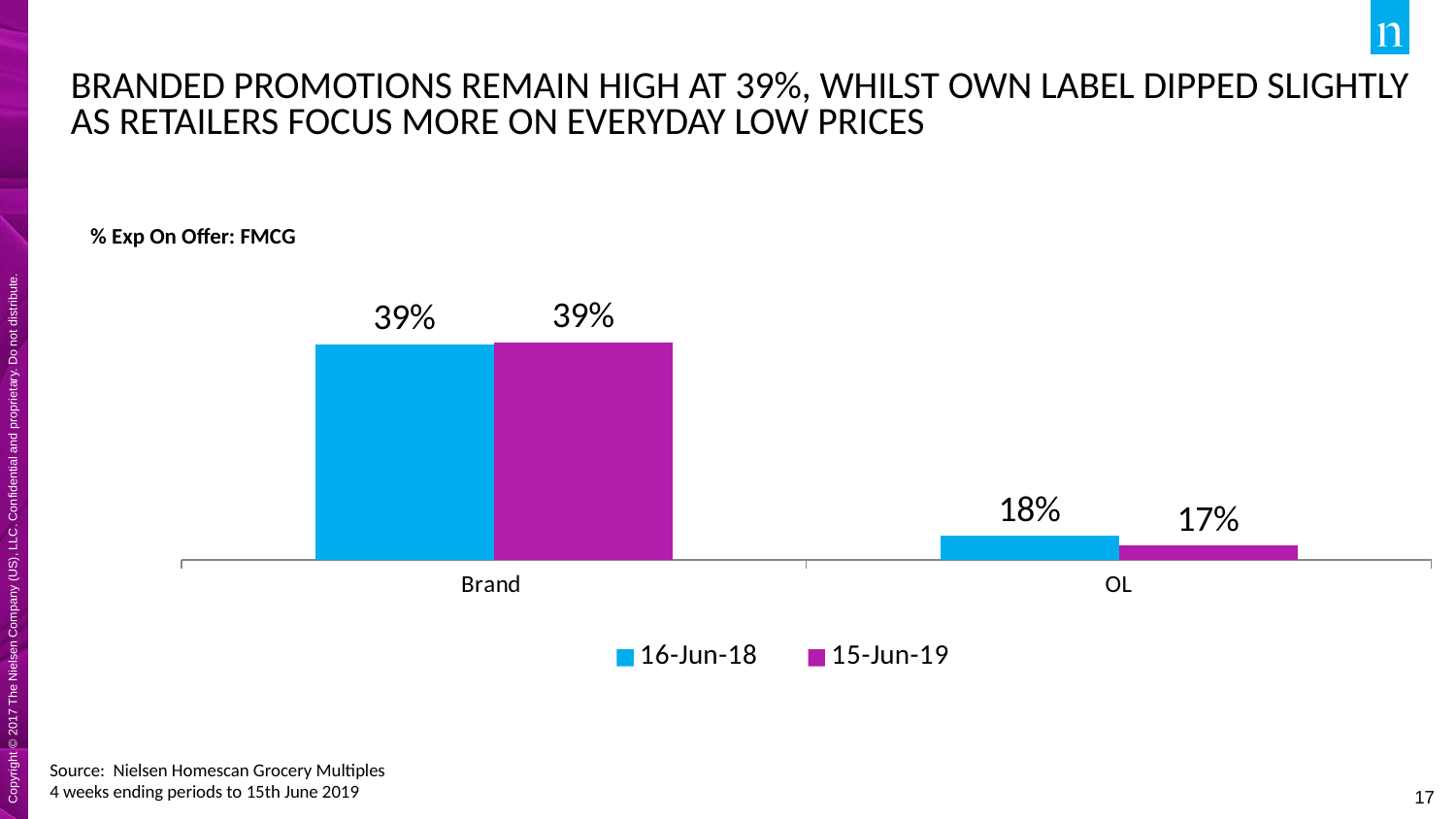
What is the value for OL in the 16-Jun-18 series? 18% What is the value for OL in the 15-Jun-19 series? 17% How many series does the legend list? 2 What kind of chart is shown on the slide? Bar chart What is the difference between the Brand and OL values in the 16-Jun-18 series? 21% What is the value for Brand in the 15-Jun-19 series? 39% Which is larger for OL: the 16-Jun-18 value or the 15-Jun-19 value? 16-Jun-18 Which category has the highest value in the 15-Jun-19 series? Brand What is the difference between the 16-Jun-18 and 15-Jun-19 values for OL? 1% Which category has the lowest value in the 16-Jun-18 series? OL How many categories are shown on the x axis? 2 What is the value for Brand in the 16-Jun-18 series? 39%